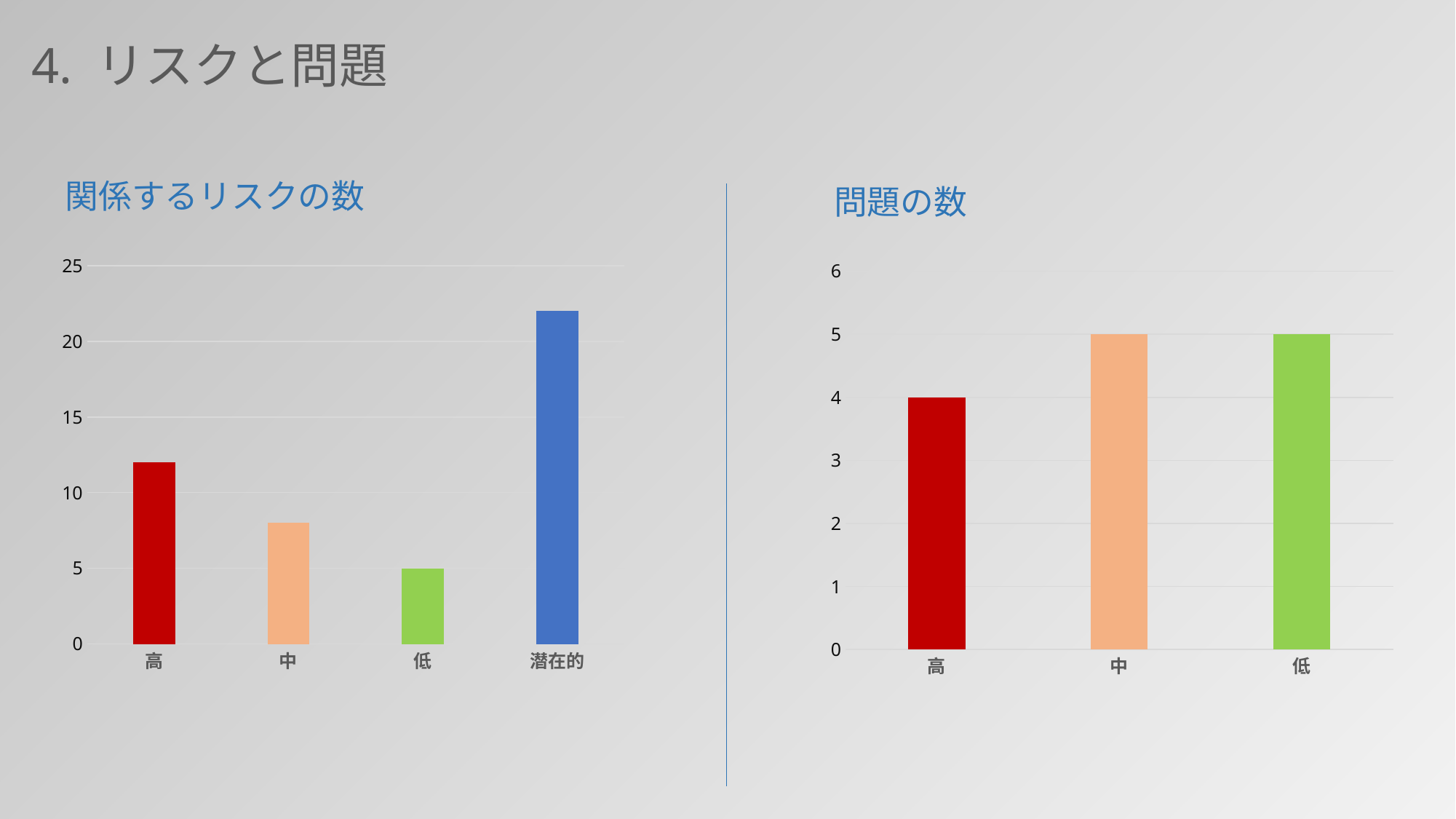
What kind of chart is the chart titled 問題の数? bar chart In the chart titled 関係するリスクの数, which category has the highest value? 潜在的 In the chart titled 関係するリスクの数, is the value for 中 greater or less than 10? less In the chart titled 関係するリスクの数, is the value for 潜在的 greater or less than 20? greater In the chart titled 問題の数, which category has the lowest value? 高 In the chart titled 問題の数, what is the value for 中? 5 In the chart titled 関係するリスクの数, what is the value for 低? 5 How many categories are shown in the chart titled 関係するリスクの数? 4 In the chart titled 問題の数, what is the value for 高? 4 In the chart titled 関係するリスクの数, which is larger, the value for 高 or the value for 中? 高 In the chart titled 問題の数, what is the difference between the values for 中 and 高? 1 In the chart titled 関係するリスクの数, which category has the lowest value? 低